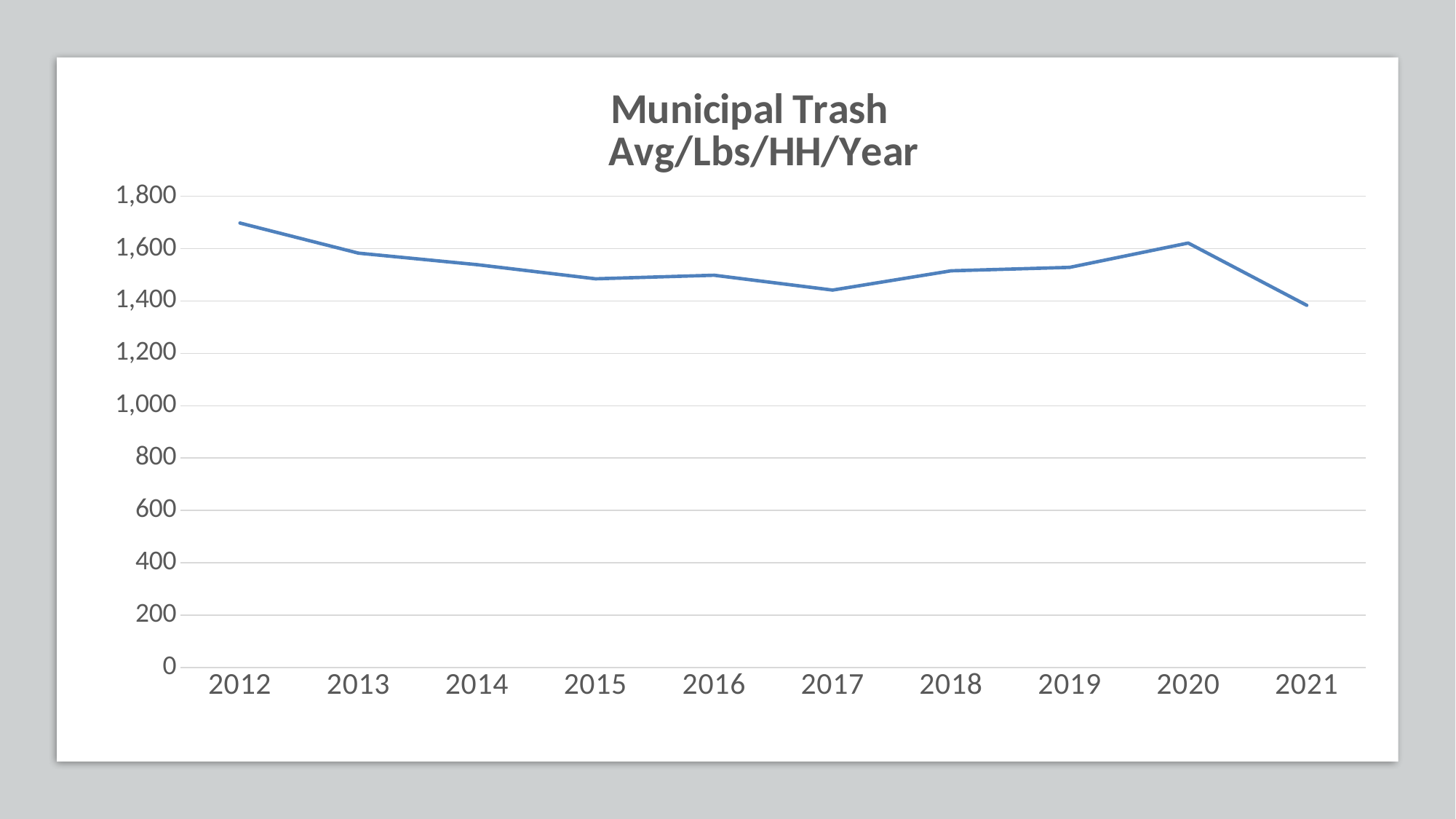
Is the value for 2012 greater or less than 1,600? greater How many years are plotted on the x axis? 10 Which is larger, the value for 2012 or the value for 2021? 2012 Is the value for 2021 greater or less than 1,400? less Which year has the highest value? 2012 Is the value for 2020 greater or less than 1,600? greater Which is larger, the value for 2020 or the value for 2017? 2020 Which year has the lowest value? 2021 What is the title of the chart? Municipal Trash Avg/Lbs/HH/Year Do the values rise or fall from 2017 to 2020? rise What kind of chart is shown on the slide? line chart